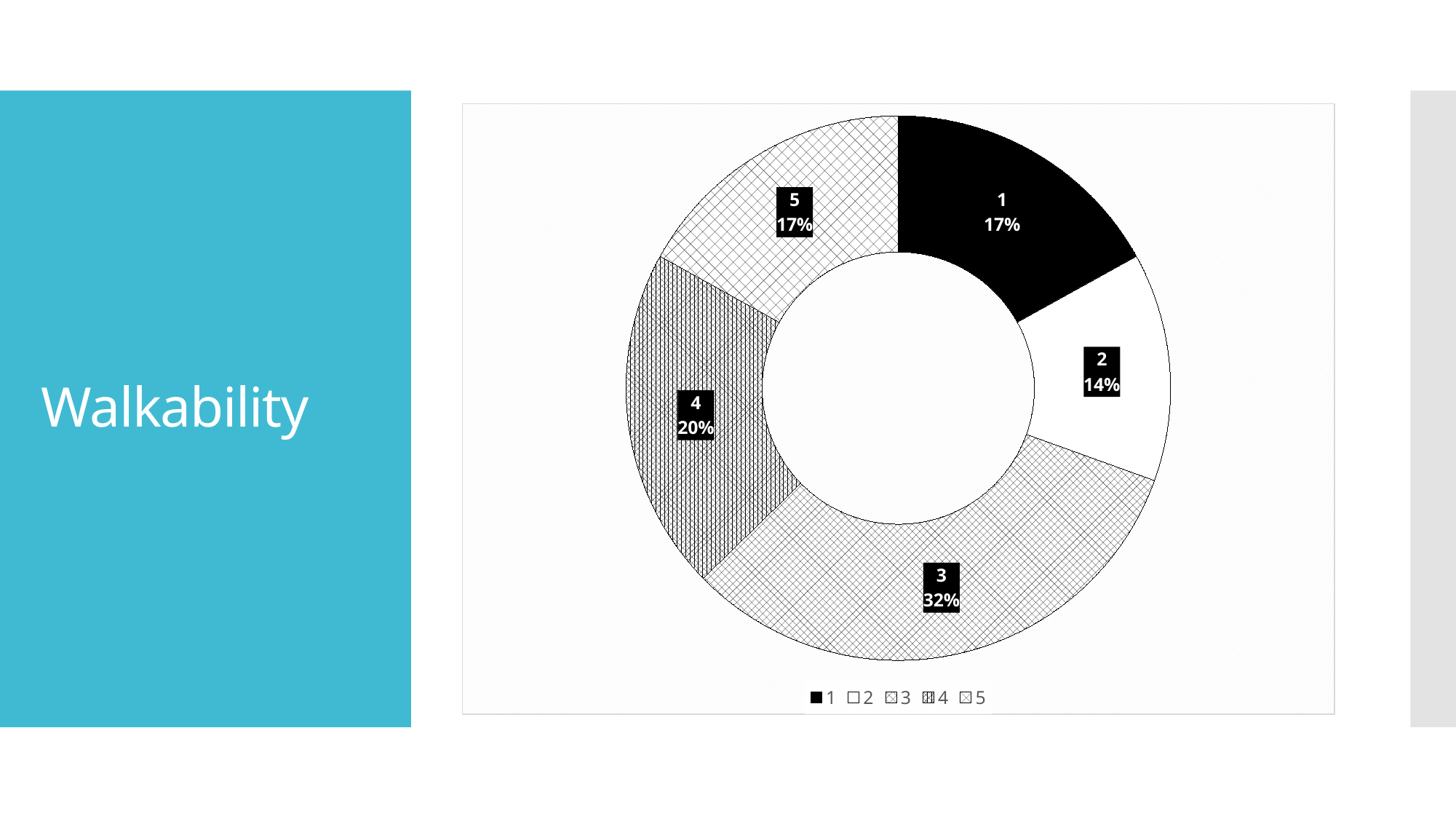
Which has a larger share, category 4 or category 5? 4 What percentage is shown for category 4? 20% What percentage is shown for category 5? 17% How many categories are shown in the chart? 5 Which category has the largest share of the chart? 3 What share of the doughnut chart does category 3 represent? 32% What is the difference in percentage points between category 1 and category 2? 3 Which category has the smallest share of the chart? 2 What is the difference in percentage points between category 3 and category 4? 12 What percentage is shown for category 2? 14% What is the title of the slide containing the chart? Walkability What type of chart is shown on the slide? Doughnut chart